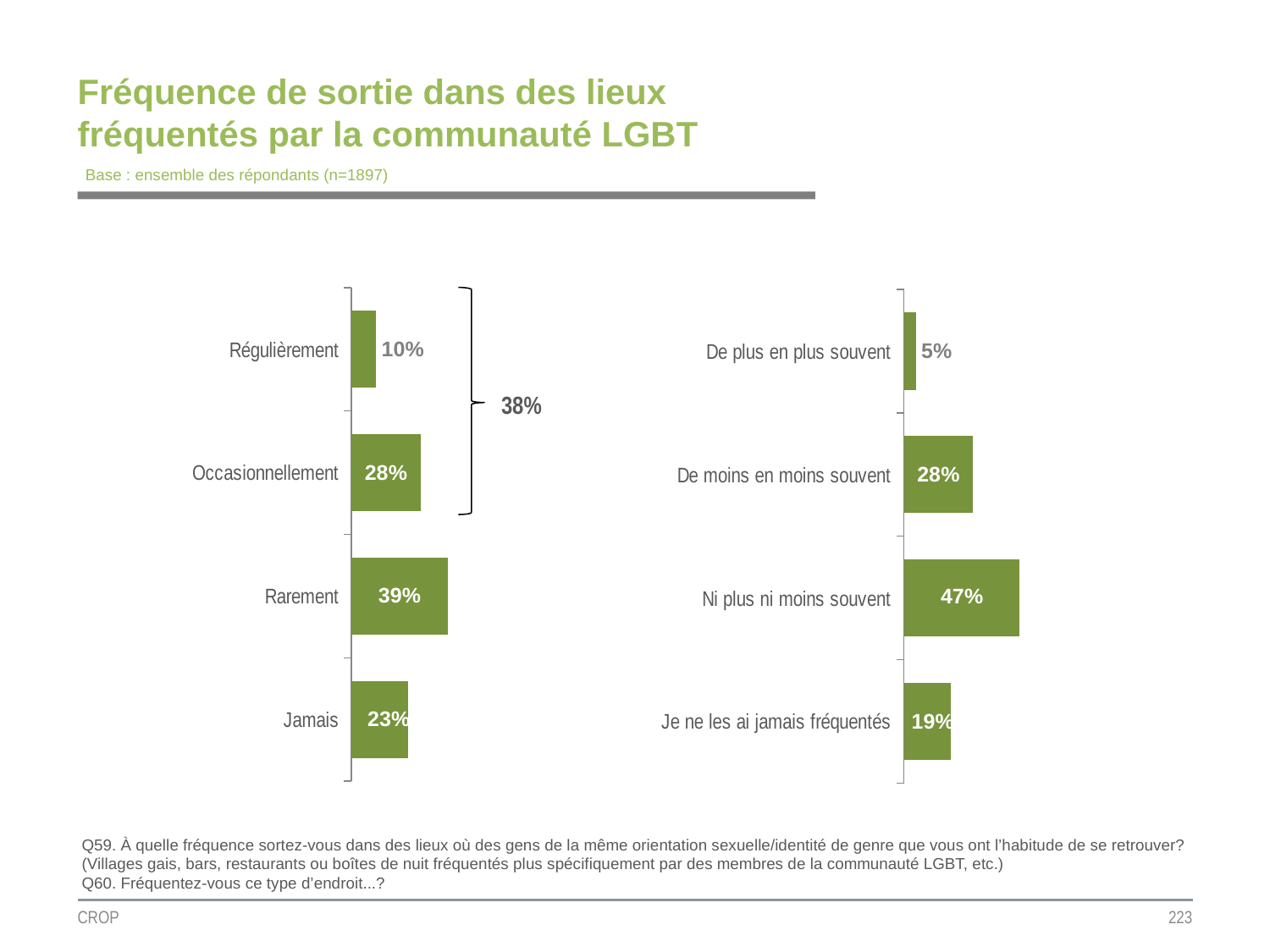
In the left chart, which category has the highest value? Rarement In the left chart, which is larger, Occasionnellement or Jamais? Occasionnellement In the left chart, what is the value for Régulièrement? 10% In the left chart, what combined value is shown by the bracket grouping Régulièrement and Occasionnellement? 38% In the right chart, what is the value for De plus en plus souvent? 5% In the left chart, what is the value for Rarement? 39% In the right chart, what is the value for Ni plus ni moins souvent? 47% What type of chart is the left chart? Bar chart In the right chart, what is the difference between Ni plus ni moins souvent and De moins en moins souvent? 19% In the right chart, which category has the lowest value? De plus en plus souvent In the left chart, what is the difference between Rarement and Jamais? 16% How many categories does the right chart show? 4